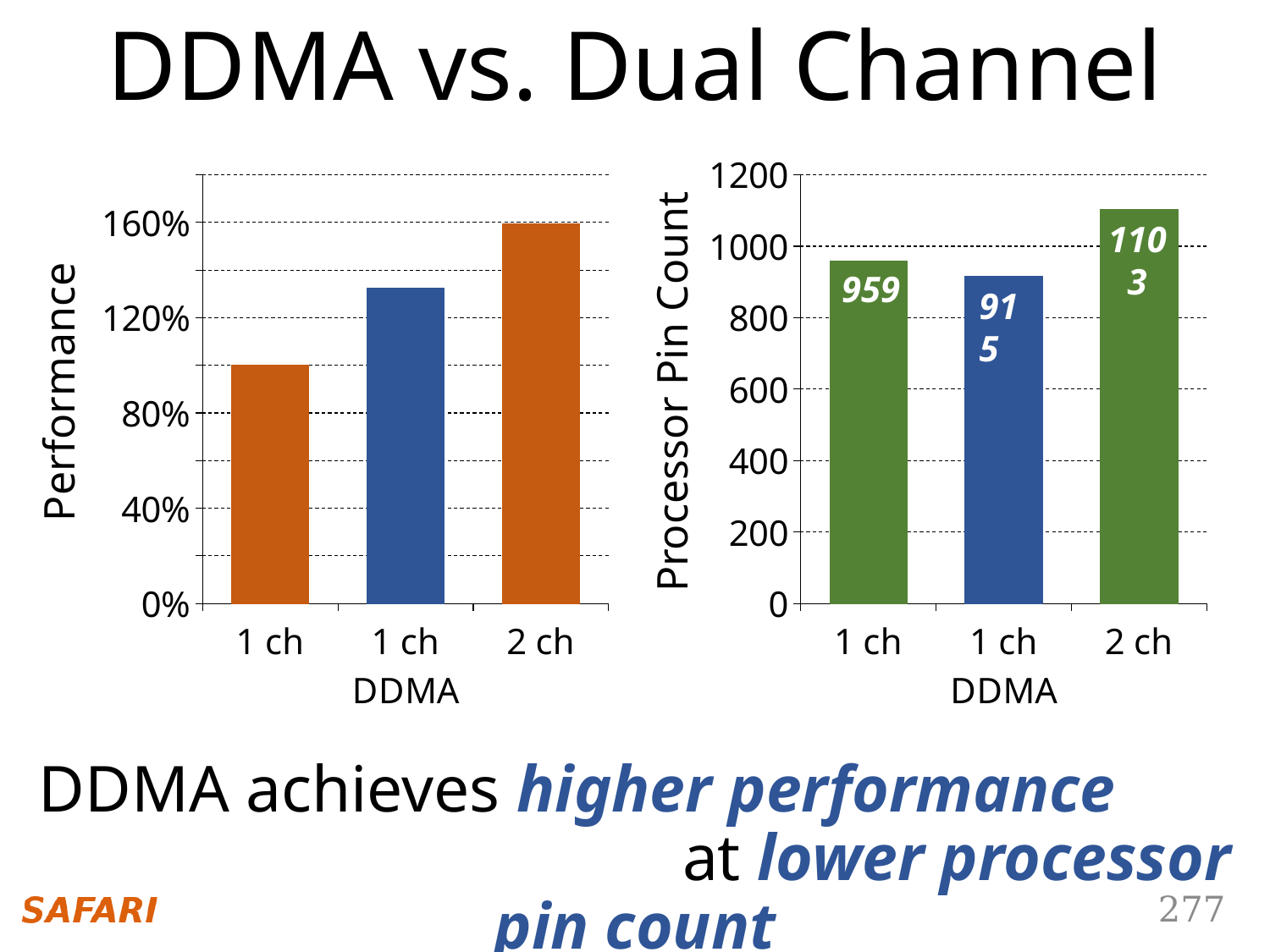
In the Performance chart on the left, is the value for 1 ch greater or less than 120%? less In the Processor Pin Count chart on the right, what is the processor pin count for 2 ch? 1103 In the Processor Pin Count chart on the right, what is the processor pin count for 1 ch DDMA? 915 In the Processor Pin Count chart on the right, how many more pins does 1 ch have than 1 ch DDMA? 44 In the Performance chart on the left, which configuration has the highest performance? 2 ch In the Performance chart on the left, is the value for 1 ch DDMA greater or less than 120%? greater In the Processor Pin Count chart on the right, which configuration has the lowest processor pin count? 1 ch DDMA In the Processor Pin Count chart on the right, what is the difference in pin count between 2 ch and 1 ch DDMA? 188 How many bars are plotted in the Performance chart on the left? 3 In the Processor Pin Count chart on the right, which configuration has the highest processor pin count? 2 ch What type of chart is the Processor Pin Count chart on the right? bar chart In the Processor Pin Count chart on the right, what is the processor pin count for 1 ch? 959